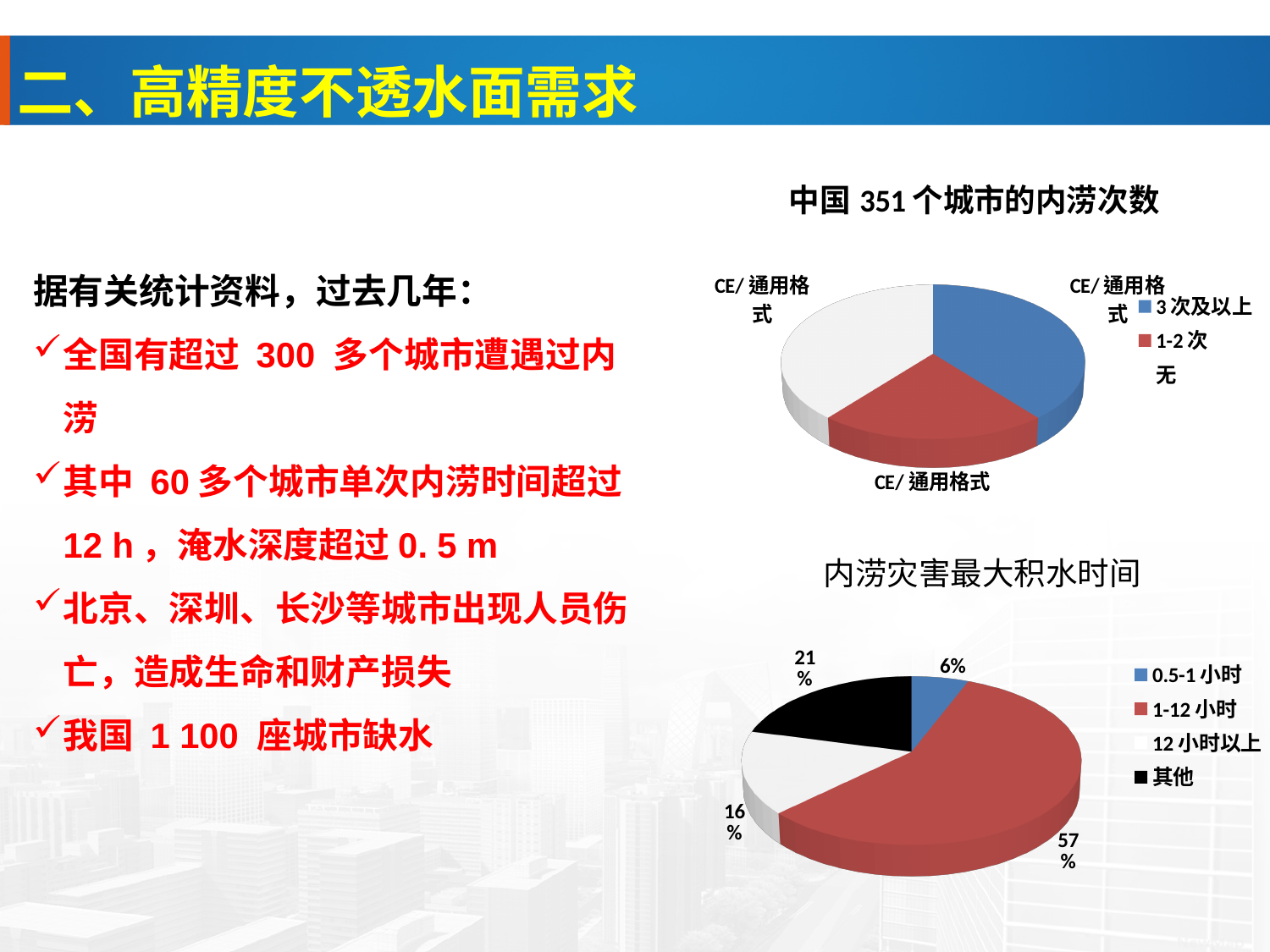
In the chart titled 内涝灾害最大积水时间, how many categories does the legend list? 4 In the chart titled 内涝灾害最大积水时间, which category has the largest slice? 1-12 小时 In the chart titled 内涝灾害最大积水时间, which category has the smallest slice? 0.5-1 小时 In the chart titled 内涝灾害最大积水时间, what share of the pie is labelled for 0.5-1 小时? 6% What kind of chart is the chart titled 中国 351 个城市的内涝次数? Pie chart In the chart titled 内涝灾害最大积水时间, what is the difference in percentage points between the 1-12 小时 slice and the 其他 slice? 36 In the chart titled 内涝灾害最大积水时间, what share of the pie is labelled for 其他? 21% In the chart titled 内涝灾害最大积水时间, what share of the pie is labelled for 1-12 小时? 57% In the chart titled 内涝灾害最大积水时间, which slice is larger: 12 小时以上 or 其他? 其他 In the chart titled 内涝灾害最大积水时间, what share of the pie is labelled for 12 小时以上? 16% In the chart titled 中国 351 个城市的内涝次数, how many categories does the legend list? 3